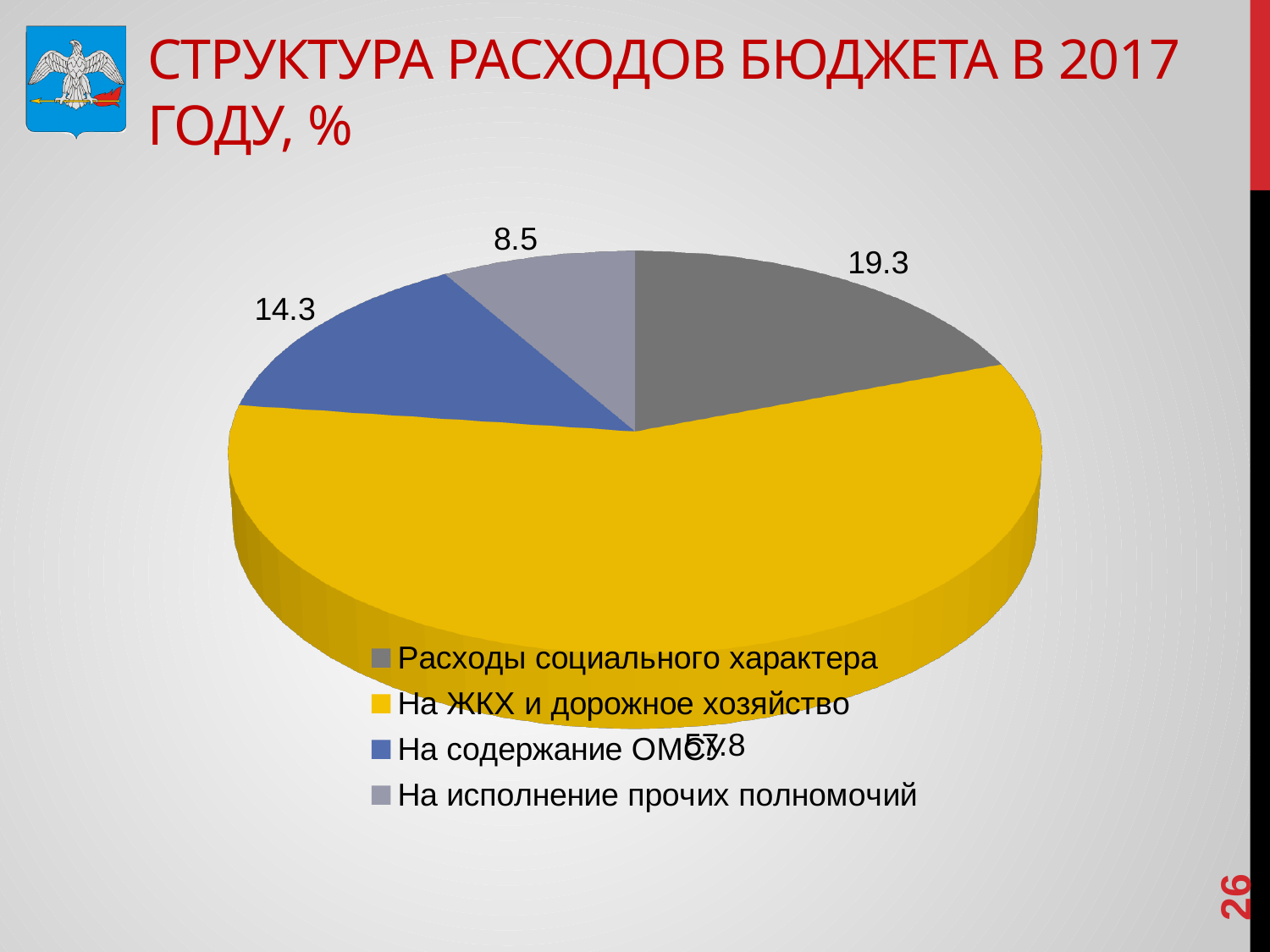
Which category has the smallest slice of the pie? На исполнение прочих полномочий What colour is the slice for 'На ЖКХ и дорожное хозяйство'? Yellow How many categories does the pie chart show? 4 Which is larger: 'Расходы социального характера' or 'На содержание ОМСУ'? Расходы социального характера What kind of chart is shown on the slide? Pie chart What is the value shown for the slice 'Расходы социального характера'? 19.3 Which category has the largest slice of the pie? На ЖКХ и дорожное хозяйство What is the value shown for the slice 'На содержание ОМСУ'? 14.3 What is the title of the slide? СТРУКТУРА РАСХОДОВ БЮДЖЕТА В 2017 ГОДУ, % What is the difference between the values for 'Расходы социального характера' and 'На содержание ОМСУ'? 5 What is the difference between the values for 'На содержание ОМСУ' and 'На исполнение прочих полномочий'? 5.8 What is the value shown for the slice 'На исполнение прочих полномочий'? 8.5